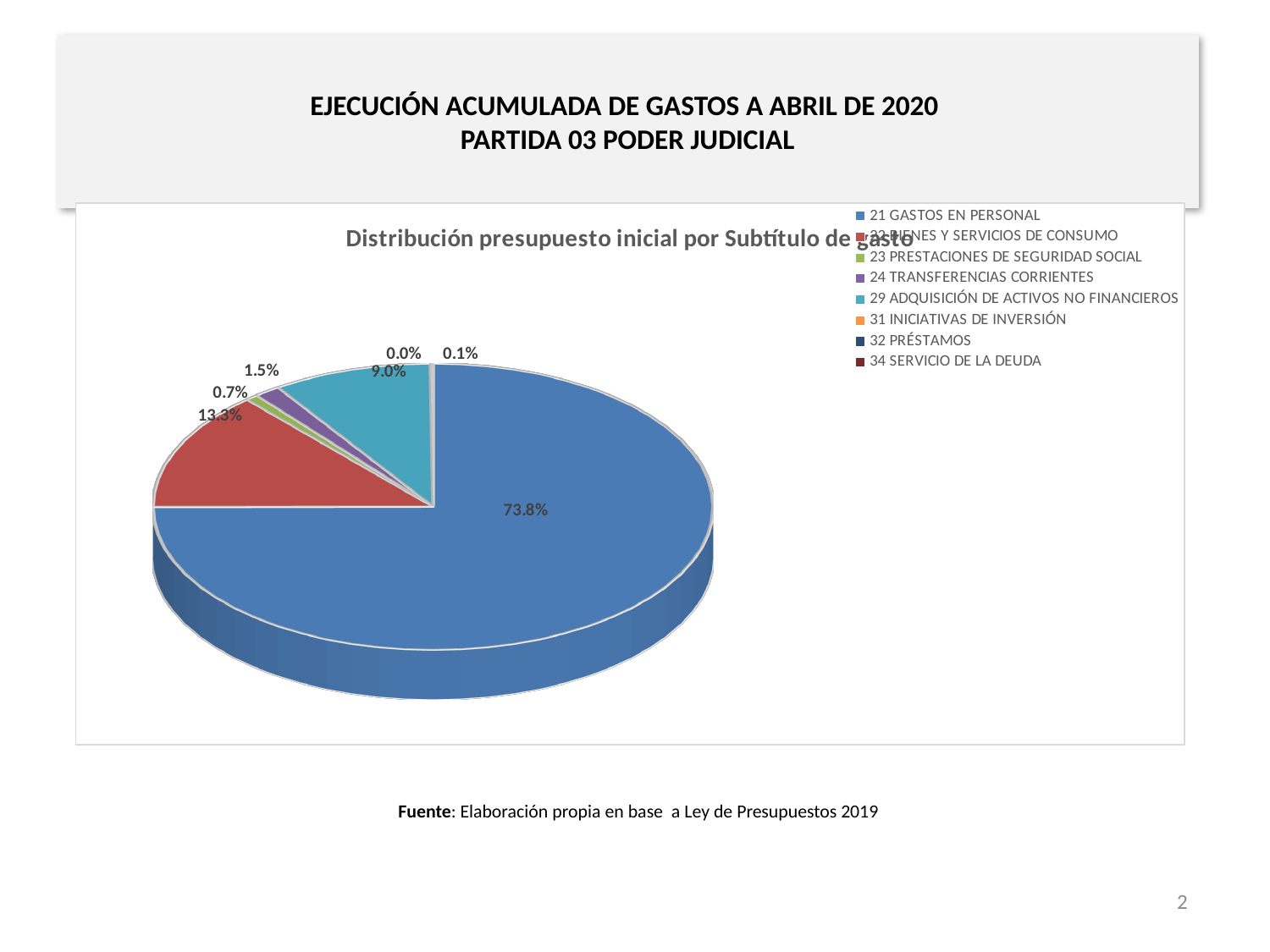
What is the title of the pie chart? Distribución presupuesto inicial por Subtítulo de gasto What share of the pie does 23 PRESTACIONES DE SEGURIDAD SOCIAL represent? 0.7% What kind of chart is shown on the slide? Pie chart By how many percentage points does the share of 21 GASTOS EN PERSONAL exceed that of 29 ADQUISICIÓN DE ACTIVOS NO FINANCIEROS? 64.8 percentage points What share of the pie does 22 BIENES Y SERVICIOS DE CONSUMO represent? 13.3% What share of the pie does 24 TRANSFERENCIAS CORRIENTES represent? 1.5% What share of the pie does 29 ADQUISICIÓN DE ACTIVOS NO FINANCIEROS represent? 9.0% Which slice is larger: 29 ADQUISICIÓN DE ACTIVOS NO FINANCIEROS or 24 TRANSFERENCIAS CORRIENTES? 29 ADQUISICIÓN DE ACTIVOS NO FINANCIEROS What colour is the slice for 21 GASTOS EN PERSONAL? Blue How many entries does the legend of the pie chart list? 8 Which category has the largest slice of the pie? 21 GASTOS EN PERSONAL What share of the pie does 21 GASTOS EN PERSONAL represent? 73.8%